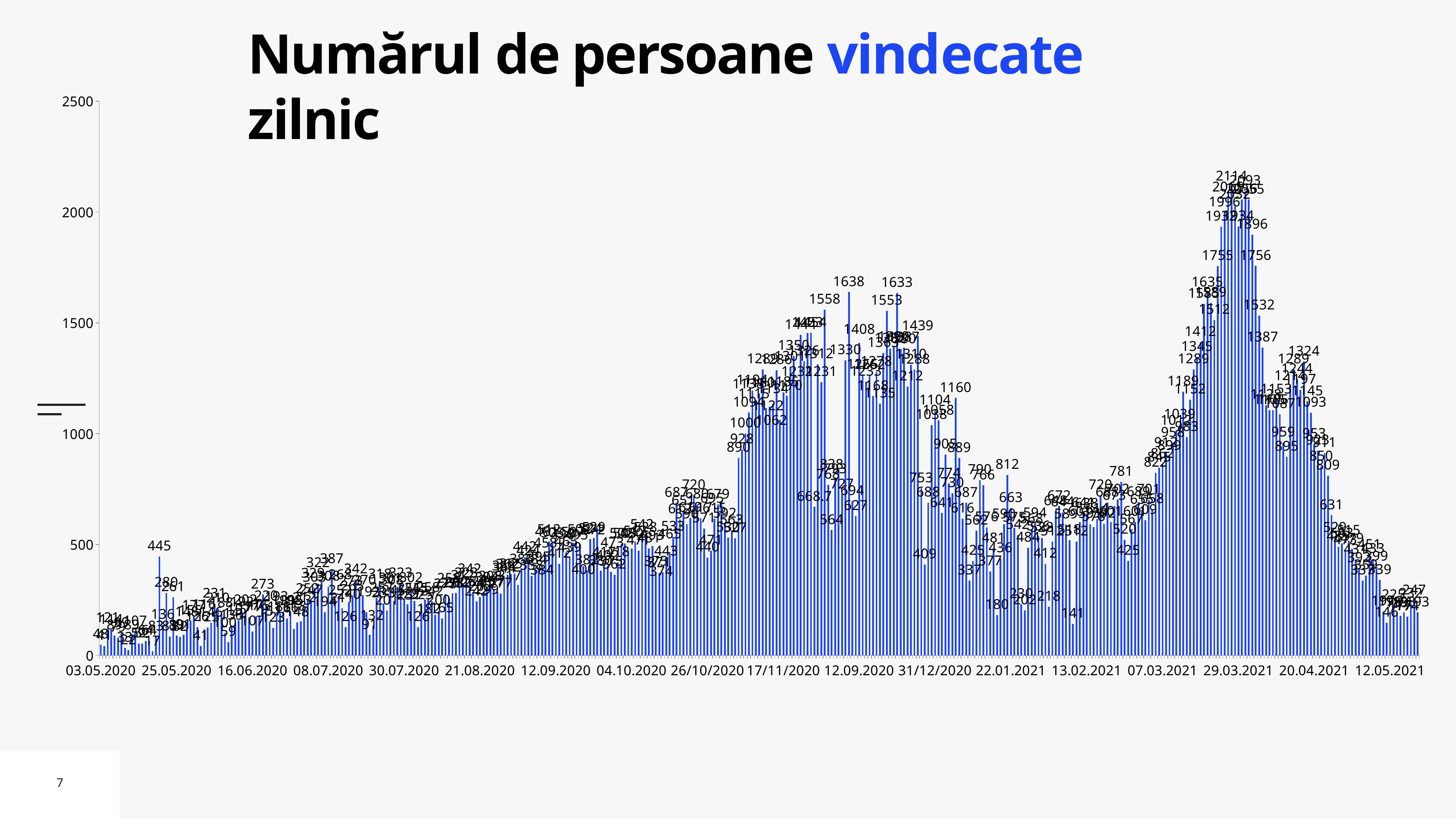
Is the value for 29.03.2021 greater or less than 1500? greater Is the value for 22.01.2021 greater or less than 1000? less What kind of chart is shown on the slide? bar chart What is the title of the chart? Numărul de persoane vindecate zilnic What is the highest value labelled in the peak around 12.09.2020 on the x axis? 1638 Is the value for 03.05.2020 greater or less than 500? less What is the difference between the two peak labels 1638 and 1633 in the late-2020 peak? 5 What is the value of the tall isolated bar labelled near 25.05.2020 that stands out above its neighbours? 445 What is the highest value labelled on the chart? 2114 What colour are the bars in the chart? blue Do the values rise or fall from 29.03.2021 to 12.05.2021? fall